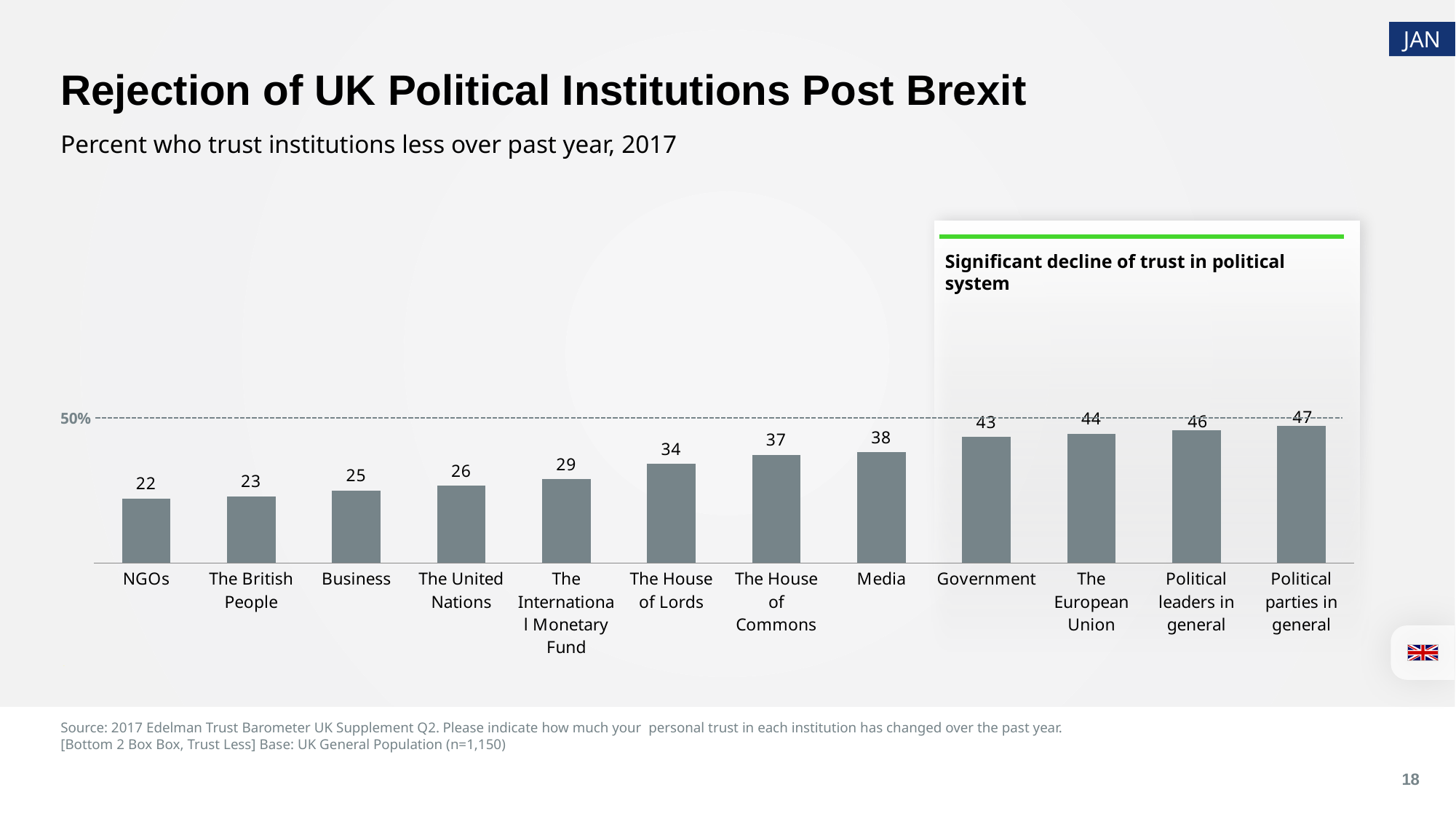
Which is larger, the value for The European Union or the value for The House of Commons? The European Union Which category has the lowest value? NGOs What kind of chart is shown on the slide? bar chart What is the text of the callout box above the right-hand bars? Significant decline of trust in political system What is the difference between the values for Political parties in general and NGOs? 25 How many categories are shown on the chart? 12 What is the value for Government? 43 Which category has the highest value? Political parties in general Is the value for Political leaders in general greater or less than 50%? less What is the value for The House of Lords? 34 What is the value for Media? 38 Do the values rise or fall from left to right along the x axis? rise